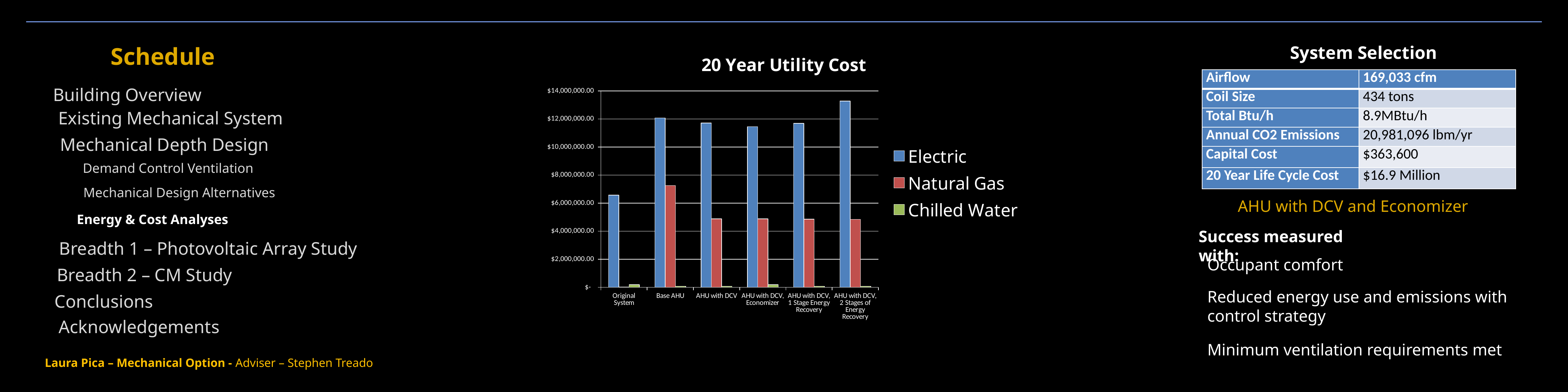
Which category has the highest Electric cost in the 20 Year Utility Cost chart? AHU with DCV, 2 Stages of Energy Recovery Which category has the highest Natural Gas cost in the 20 Year Utility Cost chart? Base AHU Is the Natural Gas cost for AHU with DCV greater or less than $6,000,000.00? less How many system categories are shown on the x axis of the 20 Year Utility Cost chart? 6 Which is larger for Base AHU: the Electric cost or the Natural Gas cost? Electric How many series does the legend of the 20 Year Utility Cost chart list? 3 Which category has the lowest Electric cost in the 20 Year Utility Cost chart? Original System What type of chart is the 20 Year Utility Cost chart? Bar chart Which series is shown in green in the 20 Year Utility Cost chart? Chilled Water Is the Electric cost for Base AHU greater or less than $10,000,000.00? greater Is the Electric cost for the Original System greater or less than $8,000,000.00? less What is the title of the chart on the slide? 20 Year Utility Cost